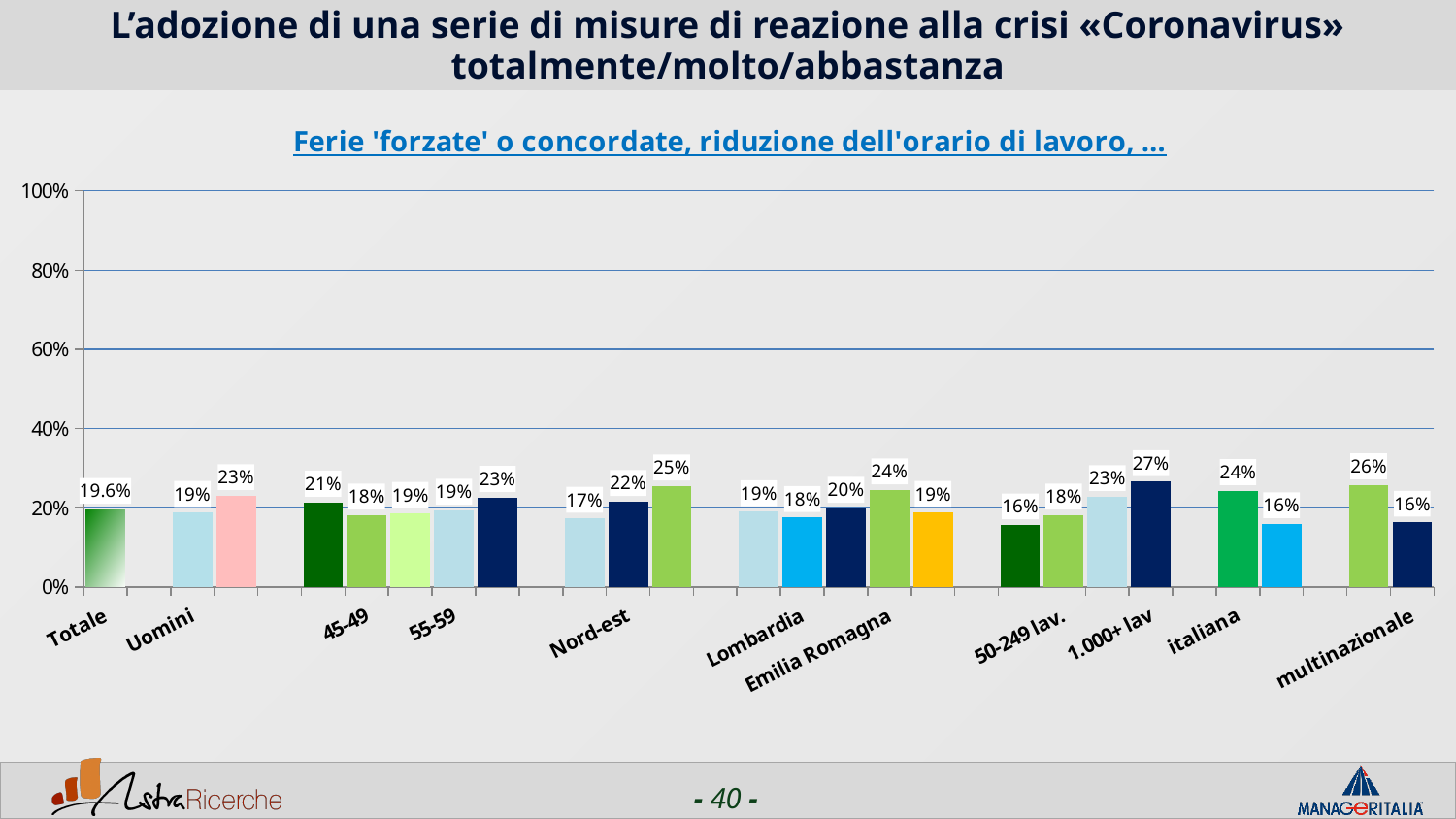
What is the value for Totale? 19.6% What is the value for 1.000+ lav? 27% What is the value for multinazionale? 16% What kind of chart is shown on the slide? bar chart What is the value for Nord-est? 22% Which is larger, the value for 1.000+ lav or the value for 50-249 lav.? 1.000+ lav What is the subtitle shown above the chart? Ferie 'forzate' o concordate, riduzione dell'orario di lavoro, … What is the value for 50-249 lav.? 18% What is the value for Emilia Romagna? 24% Which labelled category has the highest value? 1.000+ lav What is the difference between the value for 1.000+ lav and the value for 50-249 lav.? 9 percentage points Is the value for Emilia Romagna greater or less than 40%? less